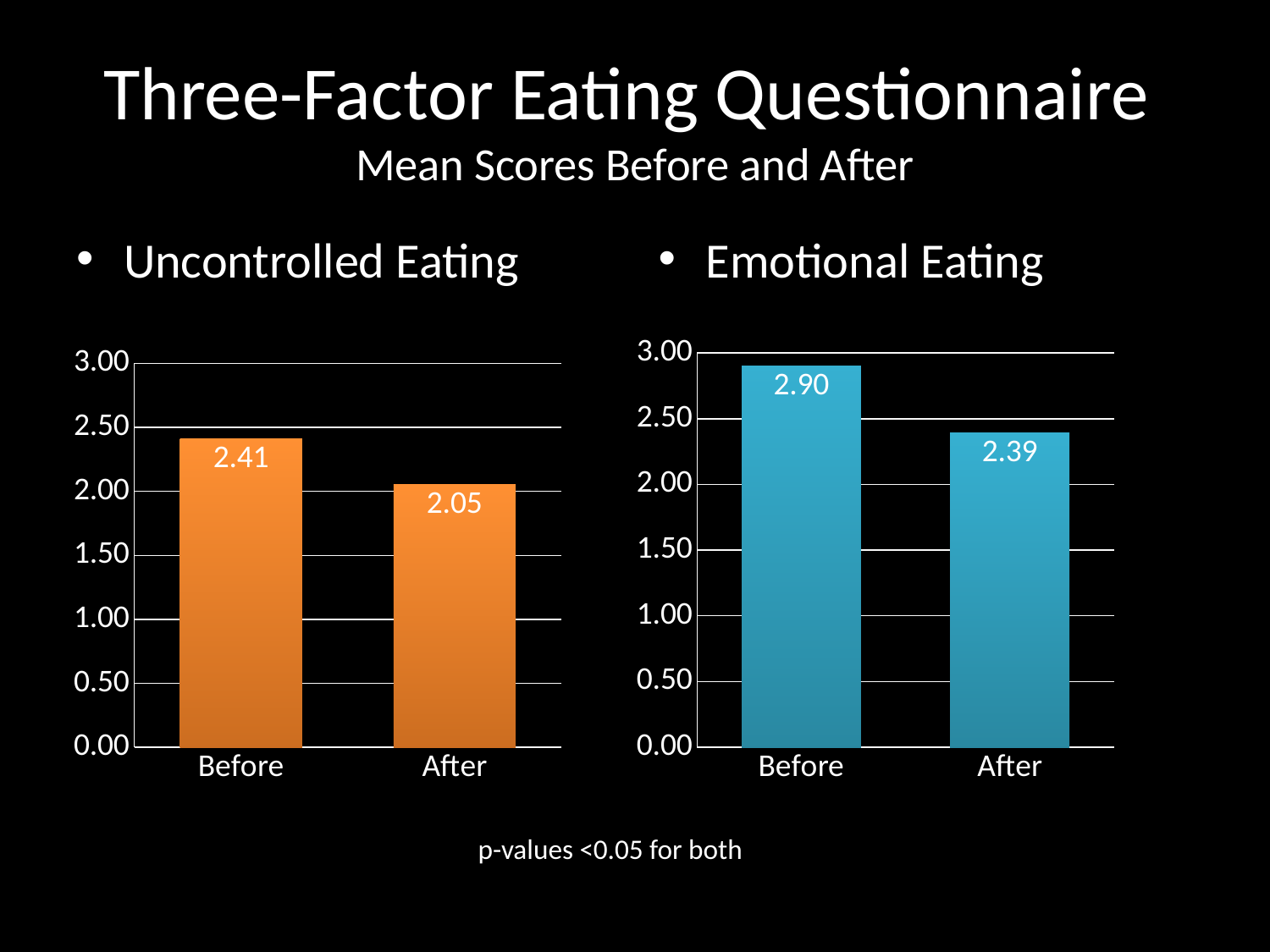
In the Uncontrolled Eating chart, which category has the highest value? Before In the Emotional Eating chart, what is the difference between the Before and After values? 0.51 In the Uncontrolled Eating chart, what is the difference between the Before and After values? 0.36 What kind of chart is the Emotional Eating chart? Bar chart In the Emotional Eating chart, what is the value for After? 2.39 In the Emotional Eating chart, what is the value for Before? 2.90 In the Uncontrolled Eating chart, do the values rise or fall from Before to After? Fall In the Emotional Eating chart, which category has the lowest value? After In the Uncontrolled Eating chart, what is the value for After? 2.05 In the Uncontrolled Eating chart, how many categories are shown on the x axis? 2 In the Emotional Eating chart, is the value for Before greater or less than 2.50? greater In the Uncontrolled Eating chart, what is the value for Before? 2.41